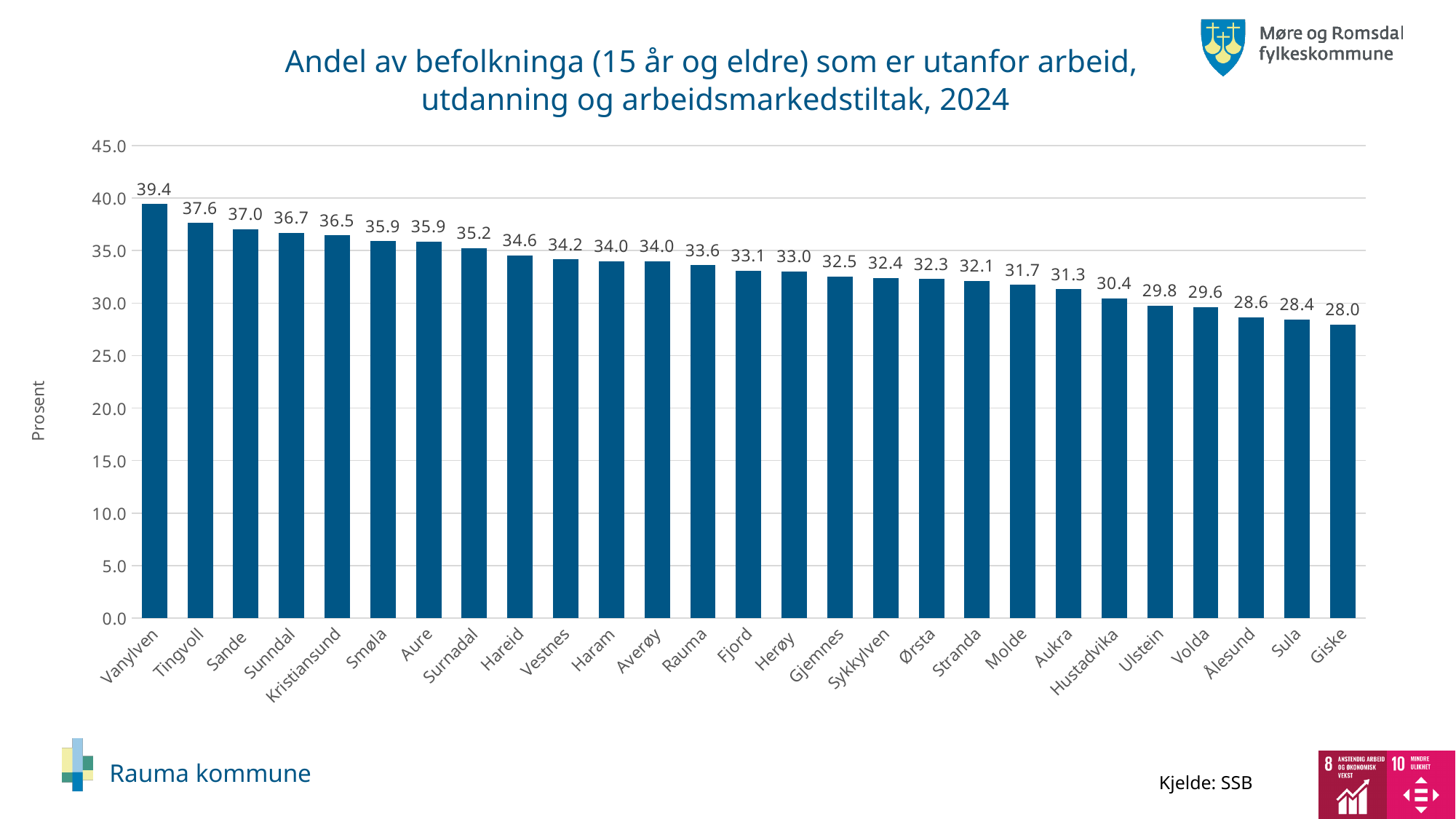
How many municipalities are shown on the chart? 27 What is the value for Rauma? 33.6 What is the difference between the values for Vanylven and Giske? 11.4 What is the difference between the values for Tingvoll and Ålesund? 9.0 Which municipality has the highest value? Vanylven What is the value for Kristiansund? 36.5 Which municipality has the lowest value? Giske Is the value for Ulstein greater or less than 30.0? less What kind of chart is shown on the slide? Bar chart What is the label on the vertical axis? Prosent Which has a larger value, Sunndal or Hustadvika? Sunndal What is the value for Molde? 31.7